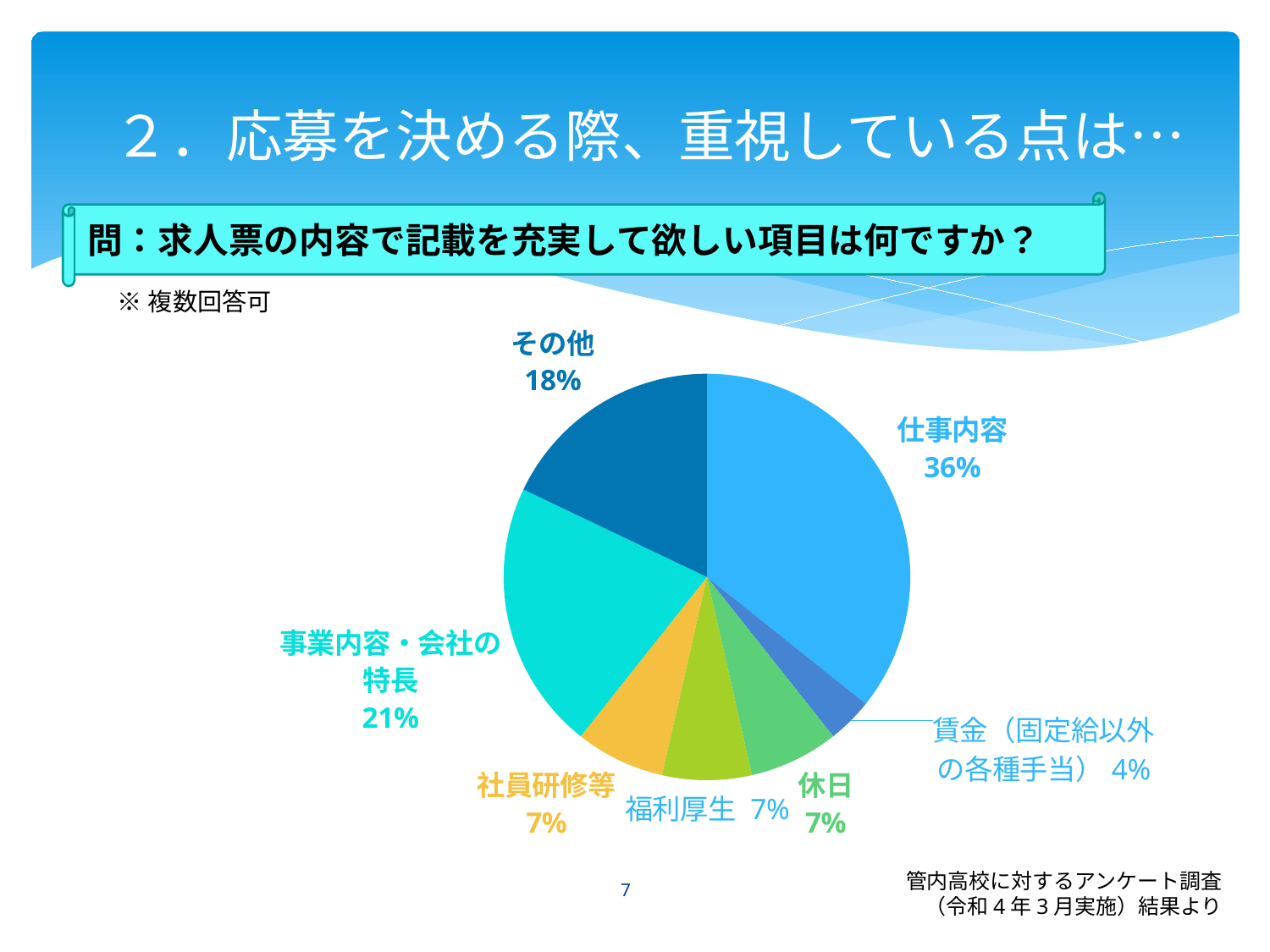
Which is larger, the share for その他 or the share for 事業内容・会社の特長? 事業内容・会社の特長 What is the difference in percentage points between 仕事内容 and 事業内容・会社の特長? 15 What percentage is shown for 休日? 7% What is the combined percentage of 社員研修等, 福利厚生 and 休日? 21% What percentage is shown for 事業内容・会社の特長? 21% What kind of chart is shown on the slide? pie chart What percentage is shown for 賃金（固定給以外の各種手当）? 4% Which category has the largest share of the pie? 仕事内容 What percentage is shown for 仕事内容? 36% Which category has the smallest share of the pie? 賃金（固定給以外の各種手当） What percentage is shown for その他? 18% How many slices does the pie chart have? 7